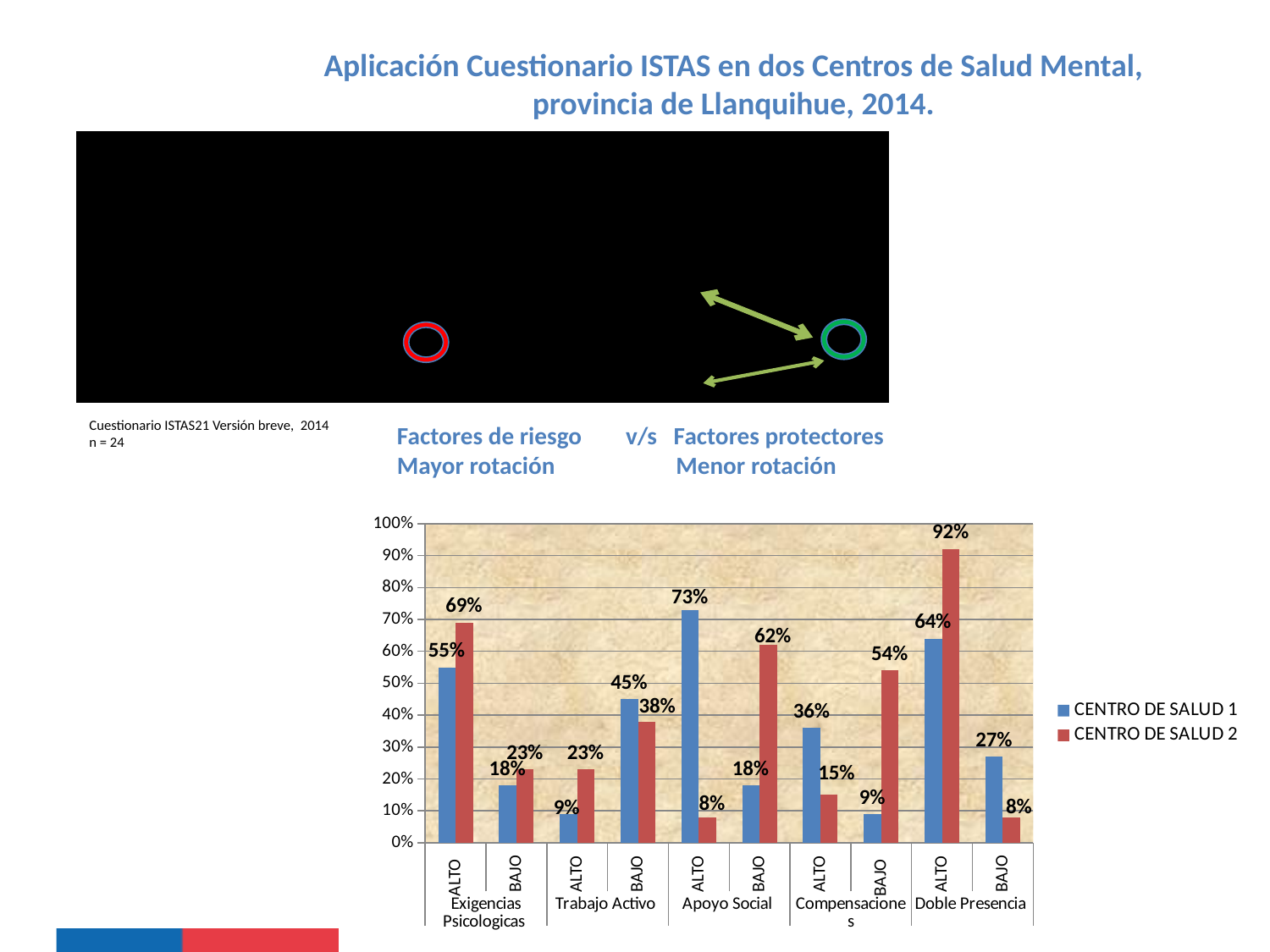
What colour represents CENTRO DE SALUD 2 in the chart? Red Which category has the highest value for CENTRO DE SALUD 2? Doble Presencia ALTO What is the value for CENTRO DE SALUD 2 in the Compensaciones BAJO category? 54% How many bars are plotted in the chart in total? 20 In the Exigencias Psicologicas ALTO category, which series has the larger value, CENTRO DE SALUD 1 or CENTRO DE SALUD 2? CENTRO DE SALUD 2 What is the value for CENTRO DE SALUD 1 in the Apoyo Social ALTO category? 73% Which category has the lowest value for CENTRO DE SALUD 1? Trabajo Activo ALTO and Compensaciones BAJO (both 9%) Is the value for CENTRO DE SALUD 1 in the Doble Presencia ALTO category greater or less than 50%? greater What is the difference between CENTRO DE SALUD 1 and CENTRO DE SALUD 2 in the Apoyo Social ALTO category? 65 percentage points How many series does the legend list? 2 What kind of chart is shown on the slide? Bar chart What is the value for CENTRO DE SALUD 2 in the Doble Presencia ALTO category? 92%